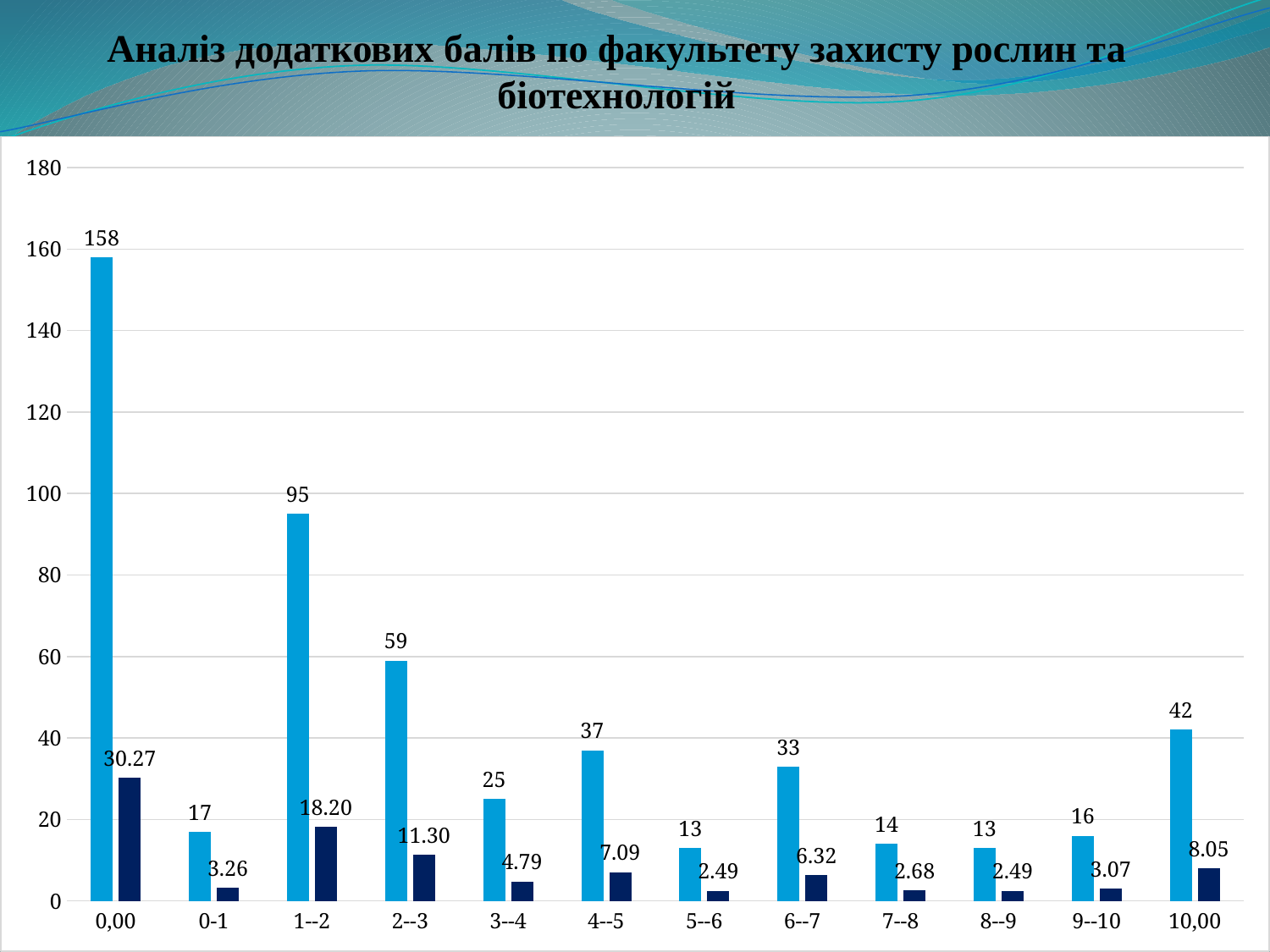
What is the value of the dark blue bar for the category 1--2? 18.20 Which category has the lowest dark blue bar value? 5--6 and 8--9 (both 2.49) Which category has the highest light blue bar? 0,00 What is the value of the dark blue bar for the category 6--7? 6.32 Which is larger: the light blue bar for 4--5 or the light blue bar for 6--7? 4--5 What type of chart is shown on the slide? bar chart What is the value of the light blue bar for the category 10,00? 42 What is the value of the light blue bar for the category 0,00? 158 What is the difference between the light blue bar values for 0,00 and 1--2? 63 Is the light blue bar for 2--3 greater or less than 60? less What is the title of the chart? Аналіз додаткових балів по факультету захисту рослин та біотехнологій How many categories are shown on the x axis? 12